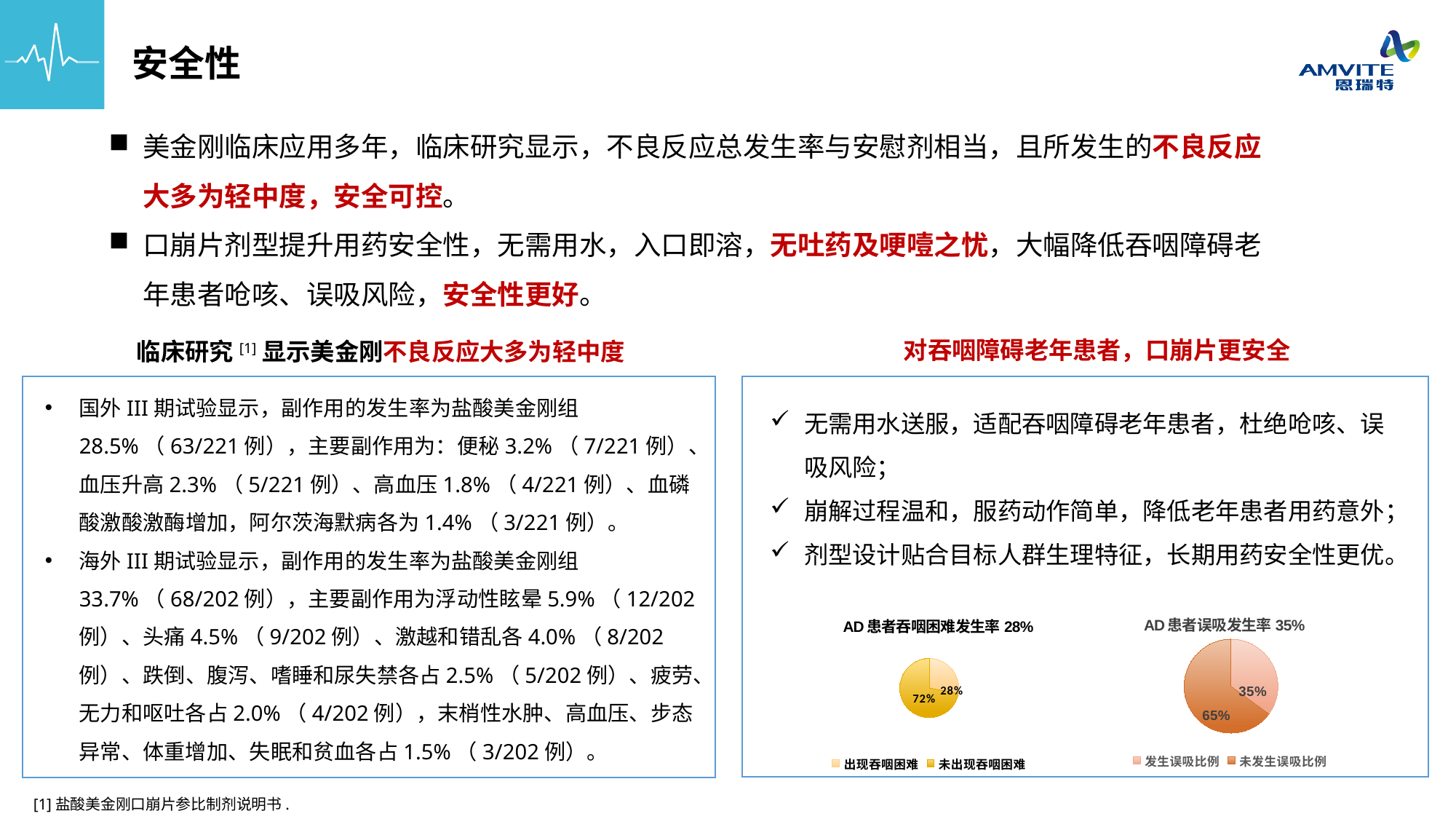
In the chart titled "AD患者误吸发生率 35%", what is the difference between the 未发生误吸比例 slice and the 发生误吸比例 slice? 30% In the chart titled "AD患者吞咽困难发生率 28%", which slice is the largest? 未出现吞咽困难 In the chart titled "AD患者误吸发生率 35%", which slice is the smallest? 发生误吸比例 Which is larger: the 出现吞咽困难 slice in the left pie chart or the 发生误吸比例 slice in the right pie chart? 发生误吸比例 In the chart titled "AD患者吞咽困难发生率 28%", what share is labelled for 出现吞咽困难? 28% What kind of chart is the chart titled "AD患者吞咽困难发生率 28%"? pie chart In the chart titled "AD患者吞咽困难发生率 28%", what is the difference between the 未出现吞咽困难 slice and the 出现吞咽困难 slice? 44% In the chart titled "AD患者误吸发生率 35%", what share is labelled for 发生误吸比例? 35% How many slices does the chart titled "AD患者误吸发生率 35%" have? 2 In the chart titled "AD患者误吸发生率 35%", what share is labelled for 未发生误吸比例? 65% How many entries does the legend of the chart titled "AD患者吞咽困难发生率 28%" list? 2